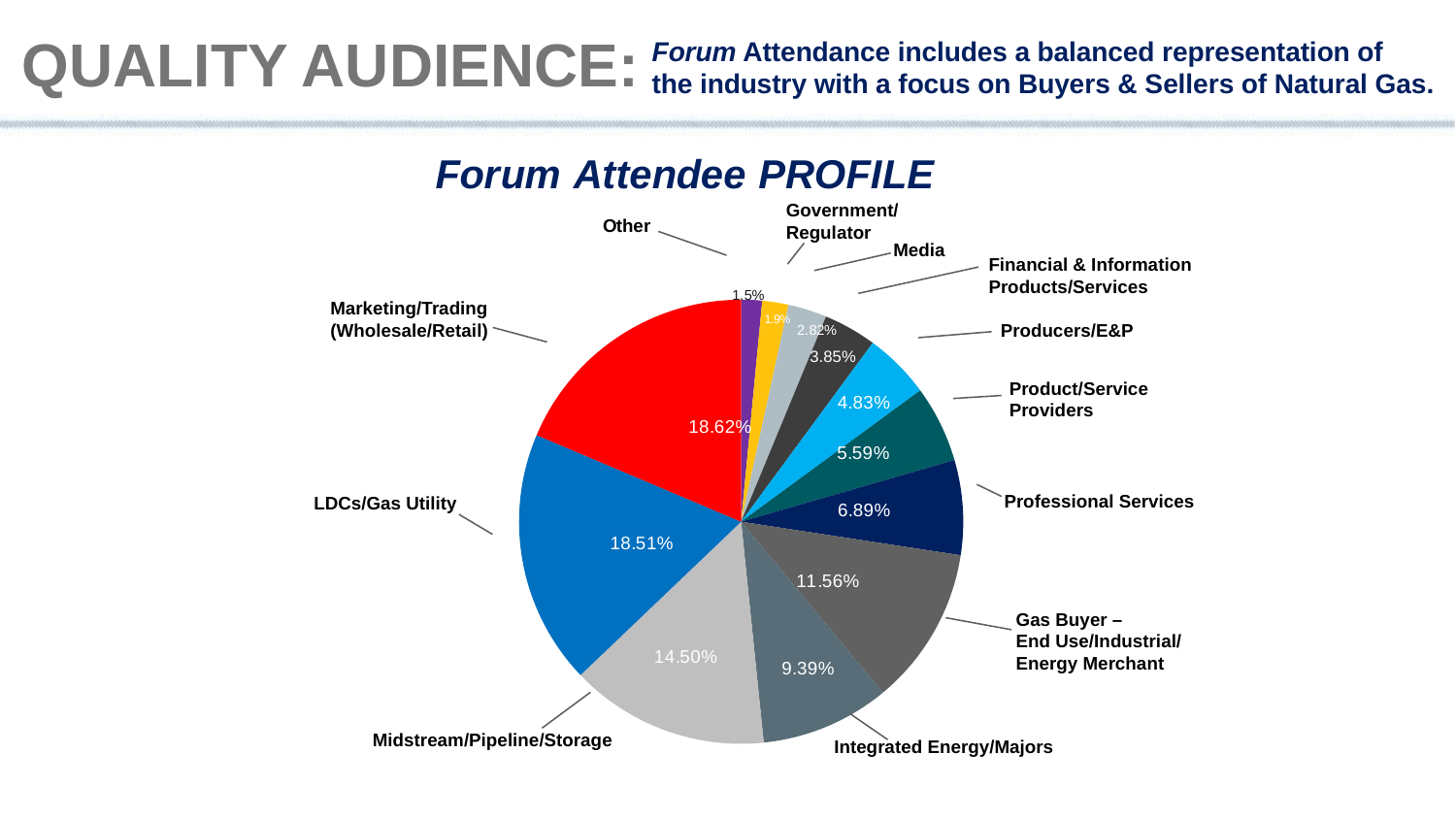
Which slice is larger, Midstream/Pipeline/Storage or Integrated Energy/Majors? Midstream/Pipeline/Storage What percentage is shown for Gas Buyer – End Use/Industrial/Energy Merchant? 11.56% What percentage is shown for Producers/E&P? 4.83% What is the title of the chart? Forum Attendee PROFILE How many categories are shown in the pie chart? 12 What percentage is shown for Integrated Energy/Majors? 9.39% What kind of chart is shown on the slide? pie chart What percentage is shown for Professional Services? 6.89% What share of forum attendees are LDCs/Gas Utility? 18.51% What percentage is shown for Product/Service Providers? 5.59% What percentage is shown for Midstream/Pipeline/Storage? 14.50% What is the difference in percentage points between Gas Buyer – End Use/Industrial/Energy Merchant and Integrated Energy/Majors? 2.17%